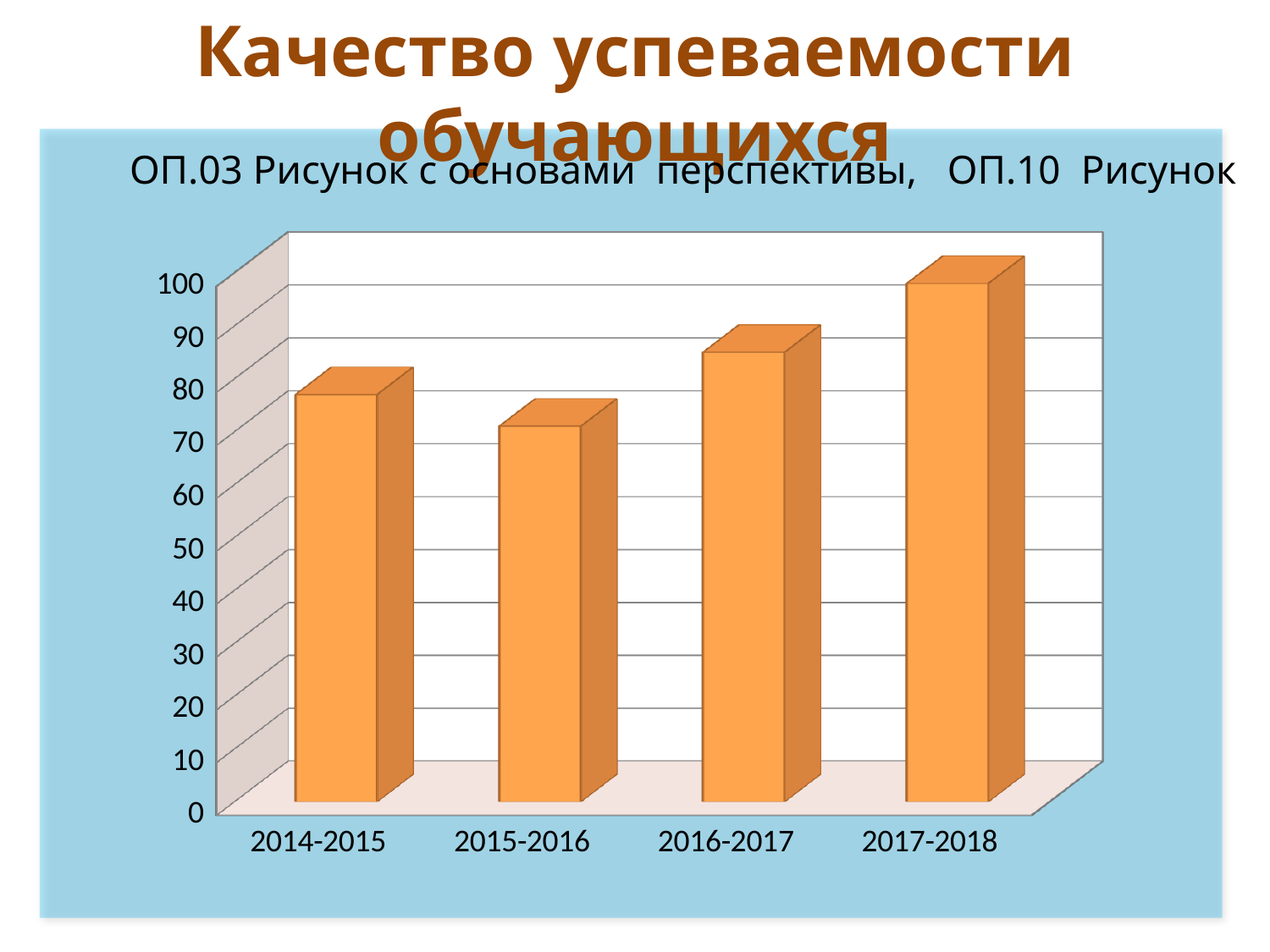
What colour are the bars in the chart? orange Do the values rise or fall from 2015-2016 to 2017-2018? rise What kind of chart is shown on the slide? bar chart Is the value for 2017-2018 greater or less than 90? greater Is the value for 2014-2015 greater or less than 70? greater Is the value for 2016-2017 greater or less than 80? greater Which is larger, the value for 2016-2017 or the value for 2014-2015? 2016-2017 How many academic years are shown on the x axis of the chart? 4 Which academic year has the highest bar in the chart? 2017-2018 What is the title of the slide above the chart? Качество успеваемости обучающихся Which academic year has the lowest bar in the chart? 2015-2016